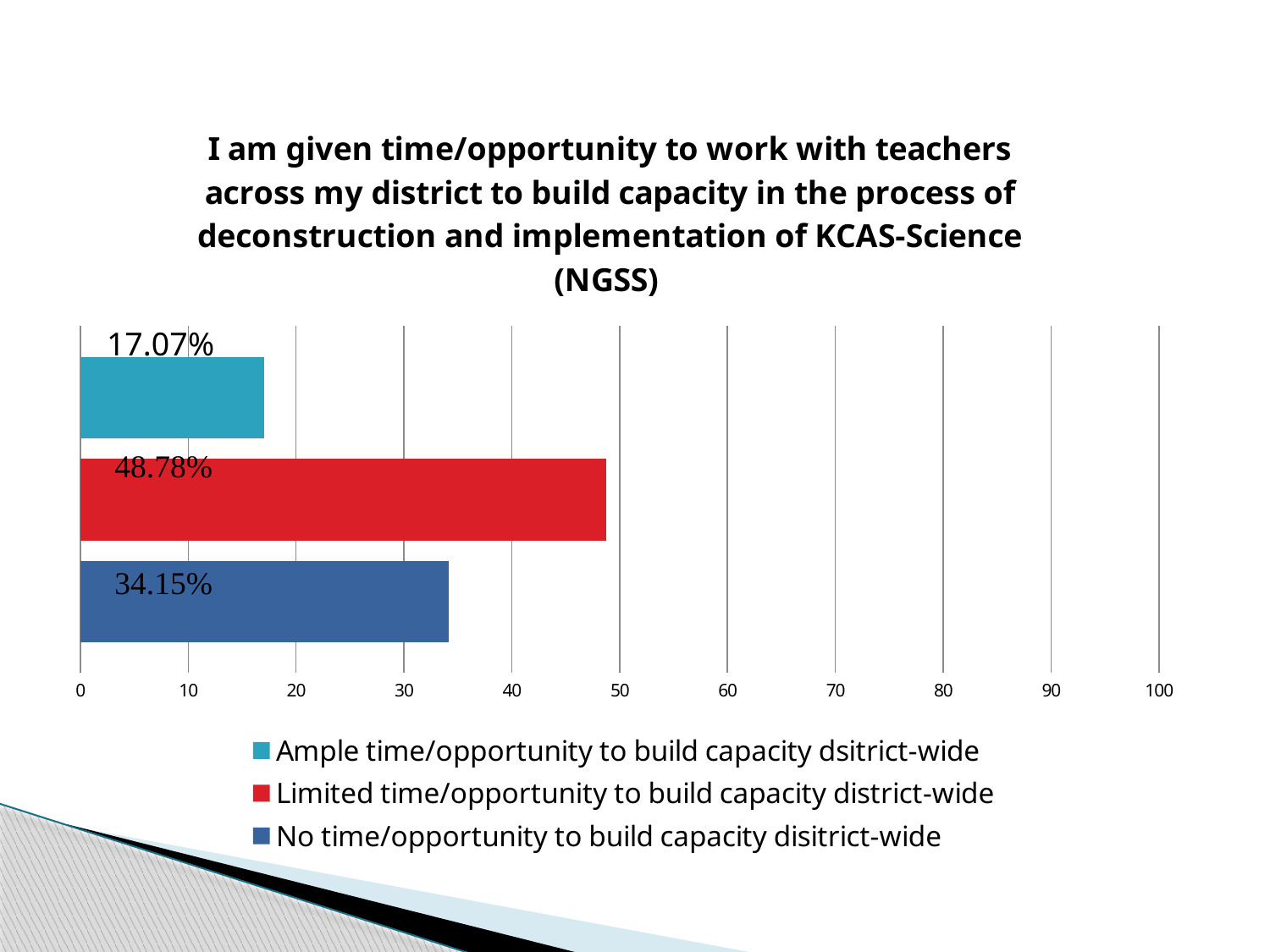
What is the value for "Ample time/opportunity to build capacity dsitrict-wide"? 17.07% What is the value for "Limited time/opportunity to build capacity district-wide"? 48.78% Which response has the highest value? Limited time/opportunity to build capacity district-wide Which response has the lowest value? Ample time/opportunity to build capacity dsitrict-wide Which is larger, the value for "No time/opportunity" or the value for "Ample time/opportunity"? No time/opportunity to build capacity disitrict-wide What colour is the bar for "Limited time/opportunity to build capacity district-wide"? Red What is the value for "No time/opportunity to build capacity disitrict-wide"? 34.15% What is the difference between the values for "No time/opportunity" and "Ample time/opportunity"? 17.08% Is the value for "Limited time/opportunity to build capacity district-wide" greater or less than 40? greater What is the difference between the values for "Limited time/opportunity" and "No time/opportunity"? 14.63% How many series does the legend list? 3 What kind of chart is shown on the slide? Bar chart